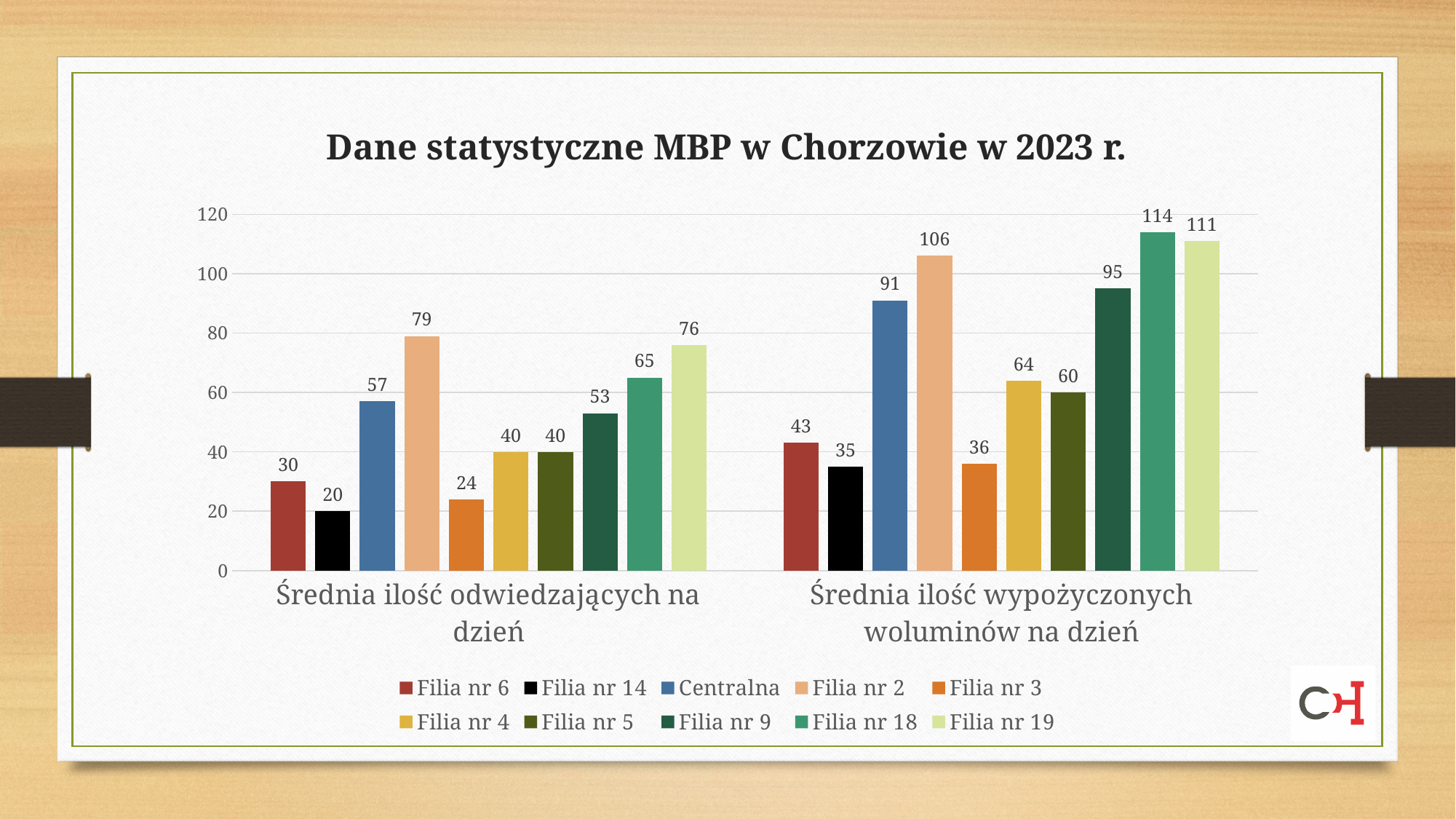
Which series has the highest value in the 'Średnia ilość wypożyczonych woluminów na dzień' category? Filia nr 18 How many series does the legend list? 10 What is the average number of borrowed volumes per day (Średnia ilość wypożyczonych woluminów na dzień) for Centralna? 91 Which series has the lowest value in the 'Średnia ilość odwiedzających na dzień' category? Filia nr 14 Is the value for Filia nr 2 in the 'Średnia ilość wypożyczonych woluminów na dzień' category greater or less than 100? greater What kind of chart is shown on the slide? Bar chart What is the difference between Filia nr 19 and Filia nr 6 in the 'Średnia ilość wypożyczonych woluminów na dzień' category? 68 In the 'Średnia ilość odwiedzających na dzień' category, which is larger: Filia nr 9 or Filia nr 18? Filia nr 18 What is the average number of visitors per day (Średnia ilość odwiedzających na dzień) for Filia nr 2? 79 What is the value for Filia nr 3 in the 'Średnia ilość odwiedzających na dzień' category? 24 How many categories are shown on the x axis? 2 What is the title of the chart? Dane statystyczne MBP w Chorzowie w 2023 r.